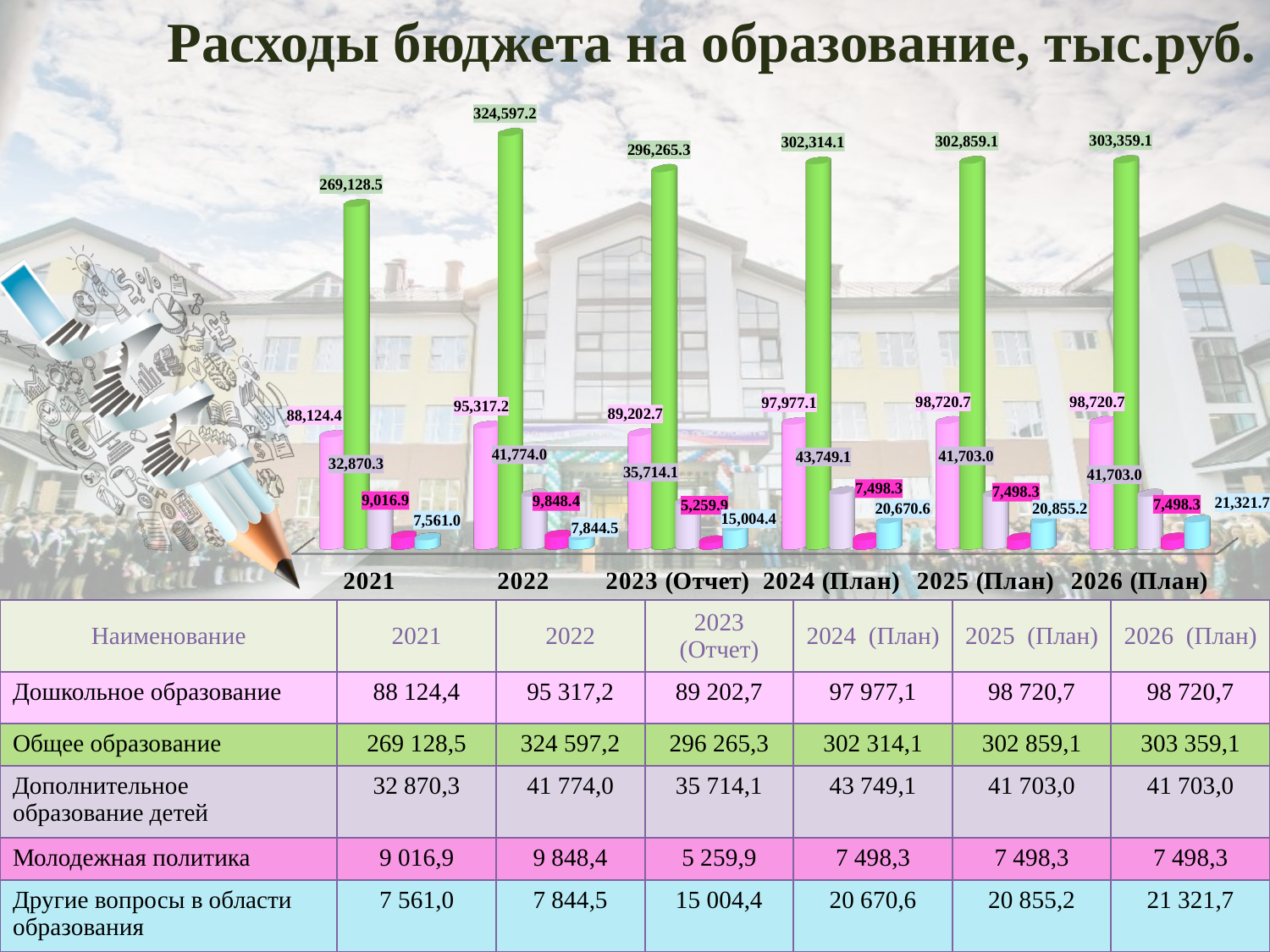
What is the value for Общее образование in 2022? 324,597.2 In which year is the value for Молодежная политика the lowest? 2023 (Отчет) What is the difference between the Дополнительное образование детей values for 2024 (План) and 2023 (Отчет)? 8,035.0 What is the value for Дошкольное образование in 2024 (План)? 97,977.1 What is the value for Другие вопросы в области образования in 2026 (План)? 21,321.7 How many data series are plotted for each year in the chart? 5 What kind of chart is shown on the slide? bar chart In which year is the value for Общее образование the highest? 2022 Do the values for Другие вопросы в области образования rise or fall from 2021 to 2026 (План)? rise How many years (categories) are shown on the x axis of the chart? 6 Which year has the larger value for Дошкольное образование, 2022 or 2023 (Отчет)? 2022 What is the difference between the Общее образование values for 2022 and 2021? 55,468.7